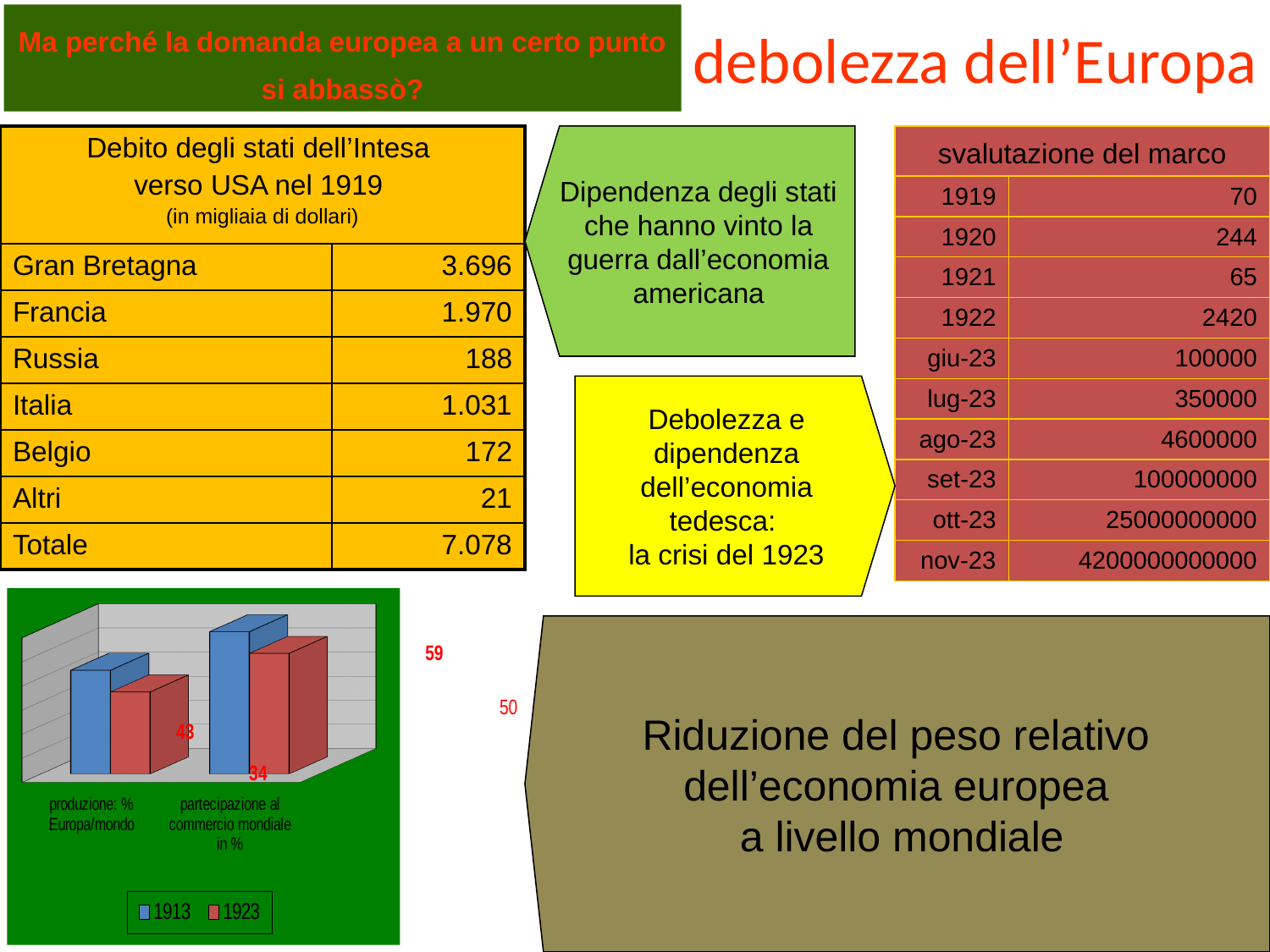
In the bar chart, which category has the higher 1923 value? partecipazione al commercio mondiale in % What are the two entries in the legend of the bar chart? 1913 and 1923 How many series does the legend of the bar chart list? 2 What kind of chart is shown at the bottom left of the slide? bar chart In the bar chart, for 'produzione: % Europa/mondo', which series has the taller bar, 1913 or 1923? 1913 In the bar chart, which category has the lower 1923 value? produzione: % Europa/mondo In the bar chart, for 'partecipazione al commercio mondiale in %', which series has the taller bar, 1913 or 1923? 1913 In the bar chart, which category has the taller 1913 bar? partecipazione al commercio mondiale in % How many categories are shown on the x axis of the bar chart? 2